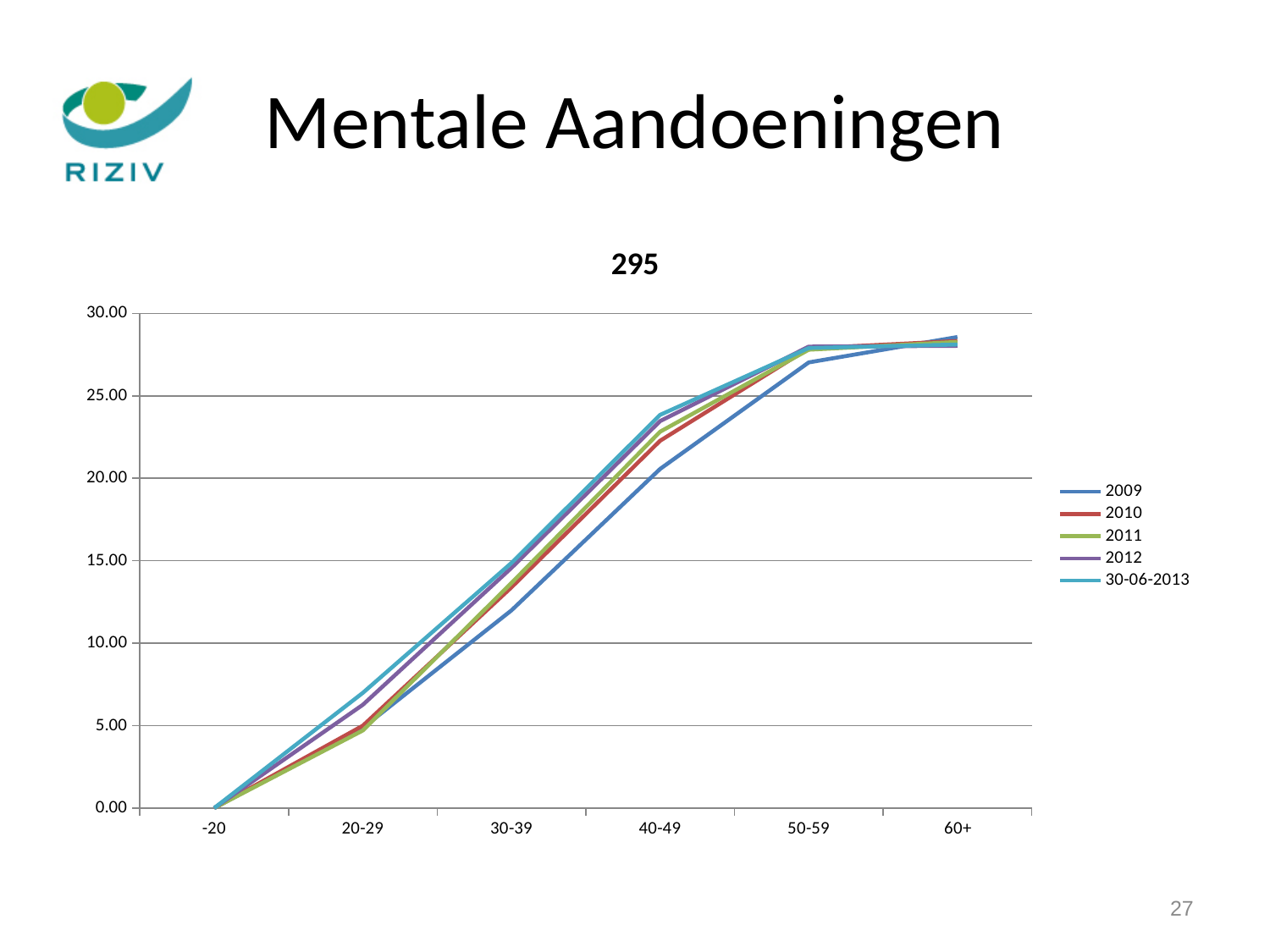
Do the values rise or fall along the x axis from -20 to 60+? rise Is the value for 2009 at 50-59 greater or less than 25.00? greater What is the title of the chart? 295 At the 20-29 category, which is larger: the value for 30-06-2013 or the value for 2011? 30-06-2013 Is the value for 2009 at 30-39 greater or less than 10.00? greater At the 40-49 category, which series has the lowest value? 2009 What kind of chart is shown on the slide? line chart Is the value for 30-06-2013 at 40-49 greater or less than 25.00? less How many series does the legend list? 5 What is the value for the 2009 series at the -20 category? 0.00 How many age categories are shown on the x axis? 6